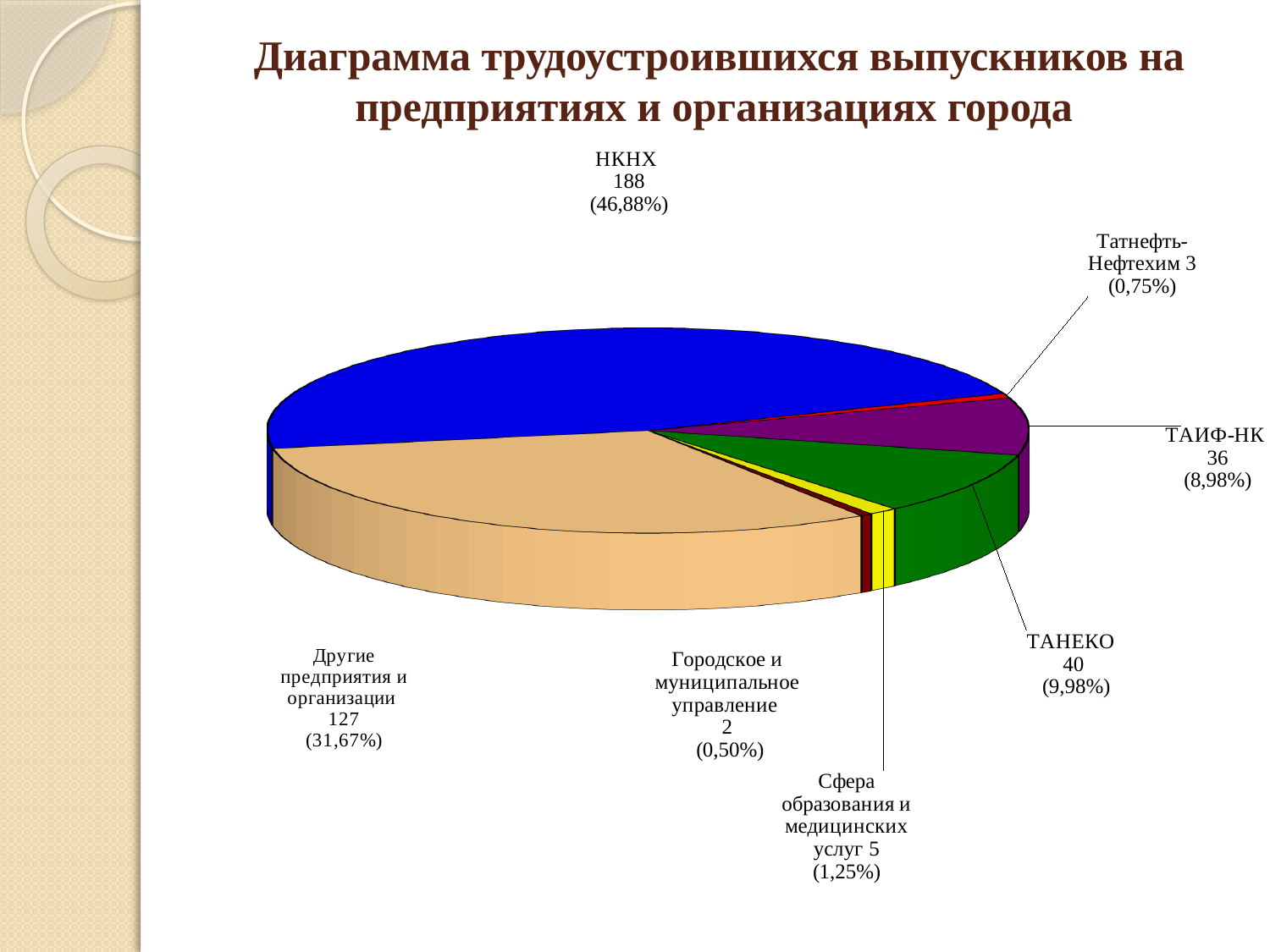
Which is larger, the value for ТАНЕКО or the value for ТАИФ-НК? ТАНЕКО What is the total number of graduates across all slices of the pie? 401 What is the difference between the number of graduates at НКНХ and at Другие предприятия и организации? 61 What type of chart is shown on the slide? Pie chart What share of the pie does ТАНЕКО represent? 9,98% Which category has the smallest slice of the pie? Городское и муниципальное управление How many categories are shown in the pie chart? 7 Which category has the largest slice of the pie? НКНХ What colour is the slice for НКНХ? Blue What percentage is shown for Другие предприятия и организации? 31,67% How many graduates were employed at ТАИФ-НК? 36 How many graduates were employed at НКНХ? 188